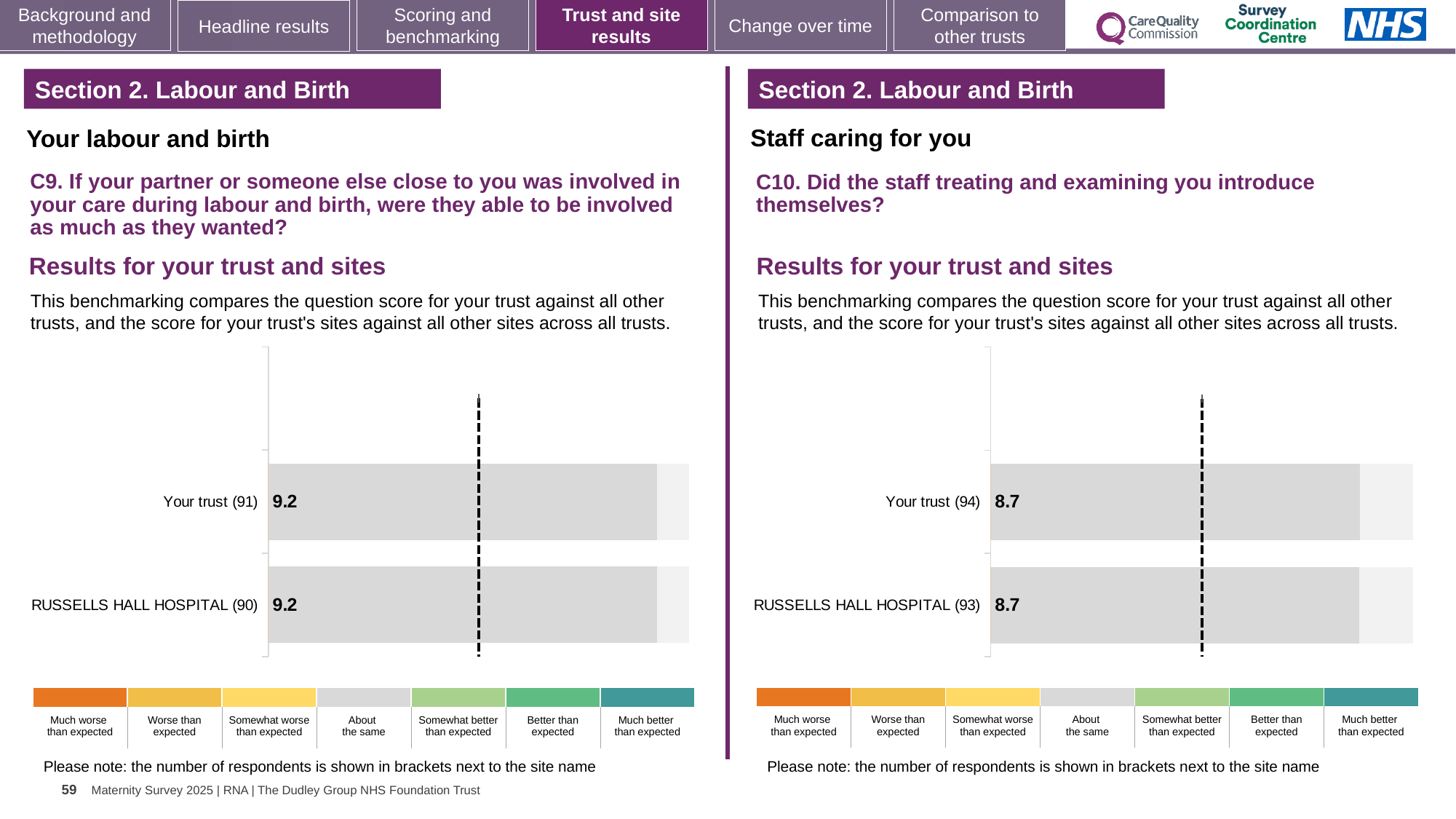
On the left chart (C9), what is the score for RUSSELLS HALL HOSPITAL? 9.2 On the left chart (C9), what is the score for Your trust? 9.2 On the right chart (C10), what is the score for RUSSELLS HALL HOSPITAL? 8.7 On the right chart (C10), what is the difference between the score for Your trust and the score for RUSSELLS HALL HOSPITAL? 0 On the right chart (C10), how many respondents are shown in brackets for RUSSELLS HALL HOSPITAL? 93 What kind of chart is used on the left (C9)? Bar chart How many bars are plotted on the right chart (C10)? 2 On the left chart (C9), what is the difference between the score for Your trust and the score for RUSSELLS HALL HOSPITAL? 0 On the left chart (C9), how many respondents are shown in brackets for Your trust? 91 Is the score for Your trust on the left chart (C9) larger or smaller than the score for Your trust on the right chart (C10)? Larger How many bars are plotted on the left chart (C9)? 2 On the right chart (C10), what is the score for Your trust? 8.7